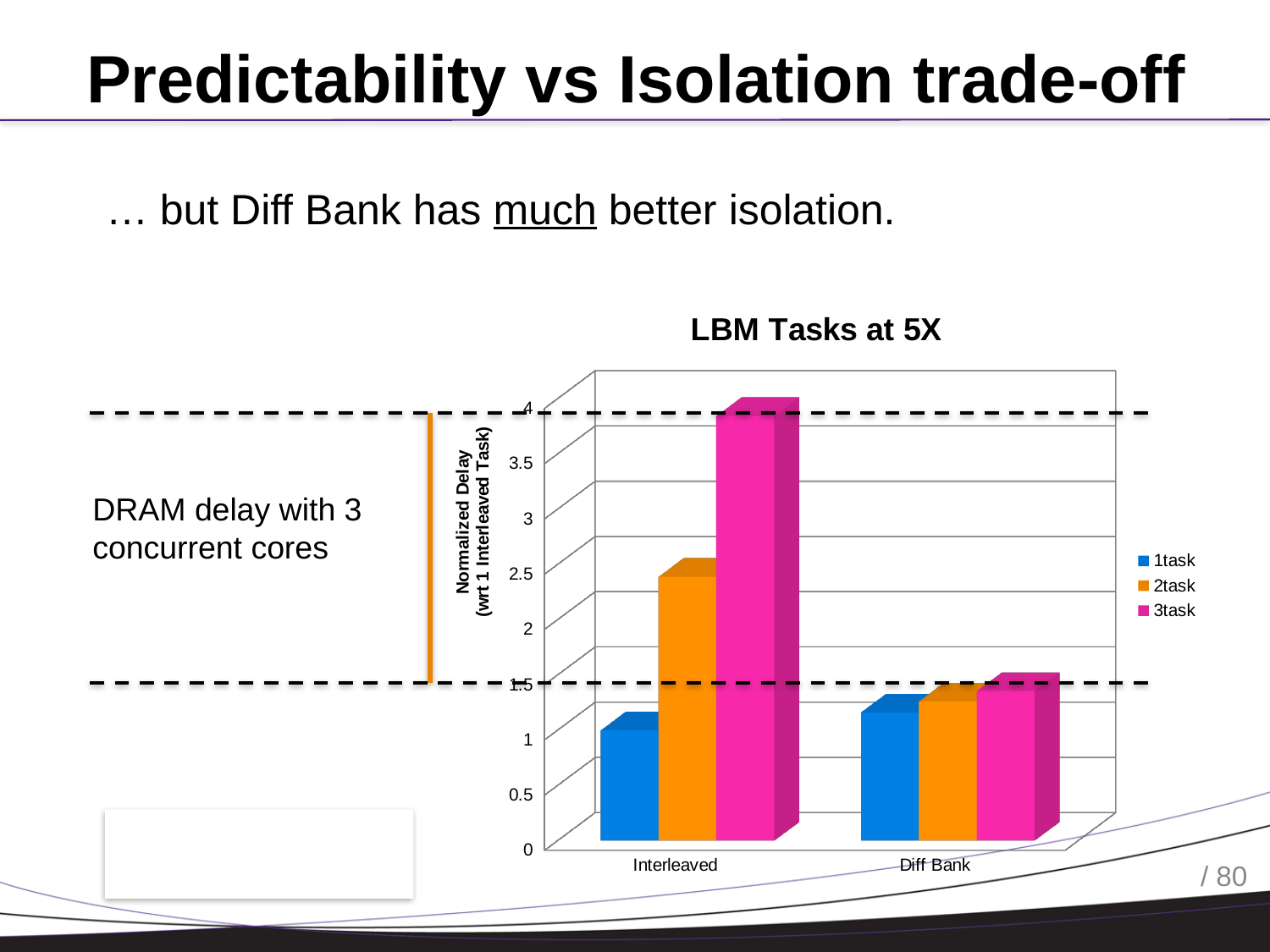
Is the 3task value for Diff Bank greater or less than 2? less Which series has the highest bar in the Interleaved category? 3task What is the label of the y axis? Normalized Delay (wrt 1 Interleaved Task) How many categories are shown on the x axis? 2 Which is larger, the 3task value for Interleaved or the 3task value for Diff Bank? Interleaved What kind of chart is shown on the slide? bar chart Which series has the lowest bar in the Interleaved category? 1task Is the 2task value for Interleaved greater or less than 2? greater What is the title of the chart? LBM Tasks at 5X How many series does the legend list? 3 Is the 3task value for Interleaved greater or less than 3? greater Which is larger, the 2task value for Interleaved or the 2task value for Diff Bank? Interleaved